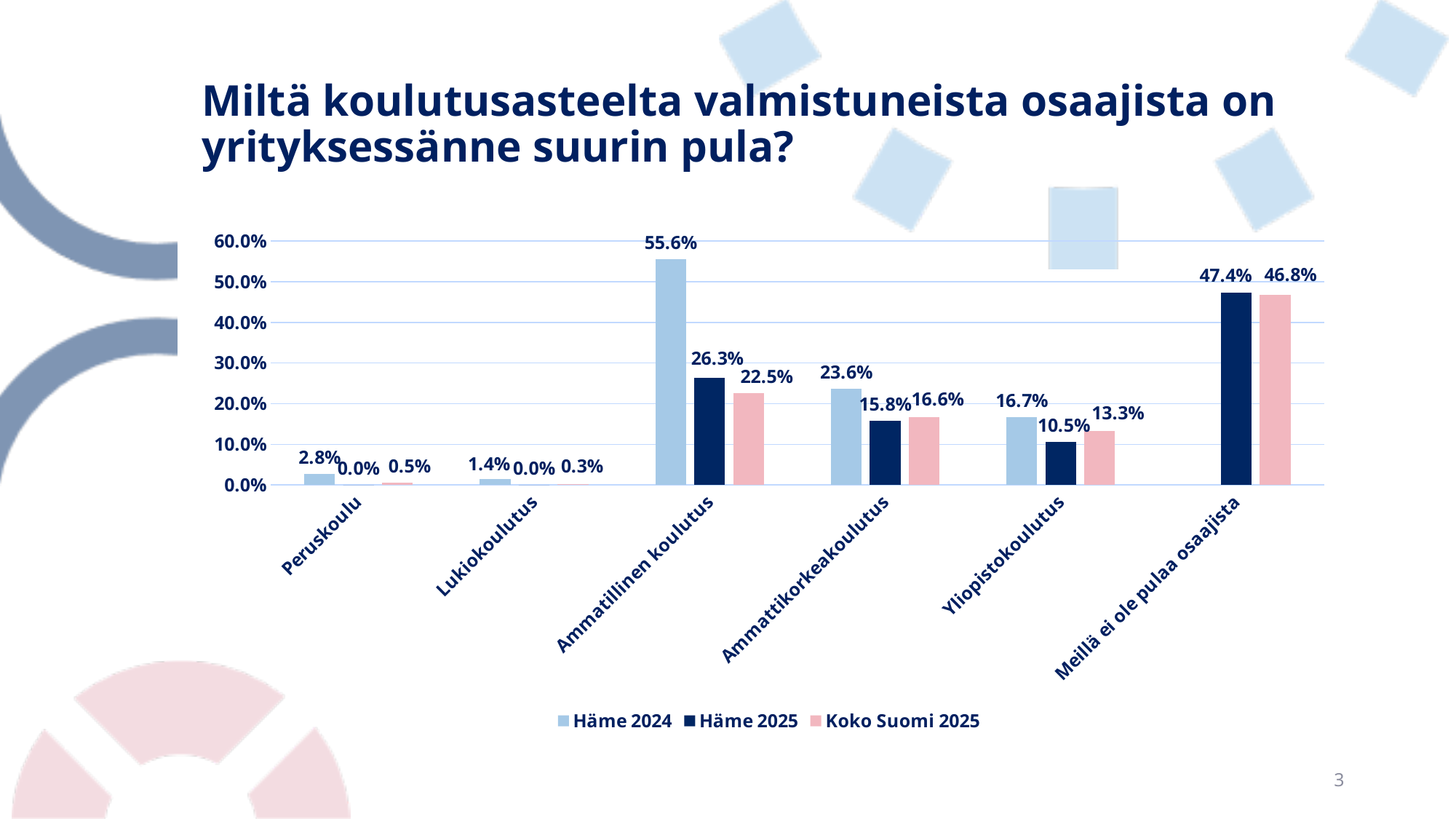
How many categories are shown on the x axis? 6 How many series does the legend list? 3 What kind of chart is shown on the slide? Bar chart Which category has the highest Häme 2025 value? Meillä ei ole pulaa osaajista What is the Häme 2024 value for Ammatillinen koulutus? 55.6% What is the difference between the Häme 2025 and Koko Suomi 2025 values for Meillä ei ole pulaa osaajista? 0.6 percentage points What is the Koko Suomi 2025 value for Yliopistokoulutus? 13.3% Which category has the lowest Koko Suomi 2025 value? Lukiokoulutus What is the Häme 2025 value for Ammattikorkeakoulutus? 15.8% Which category has the highest Häme 2024 value? Ammatillinen koulutus For Ammattikorkeakoulutus, which is larger: the Häme 2025 value or the Koko Suomi 2025 value? Koko Suomi 2025 What is the difference between the Häme 2024 and Häme 2025 values for Ammatillinen koulutus? 29.3 percentage points